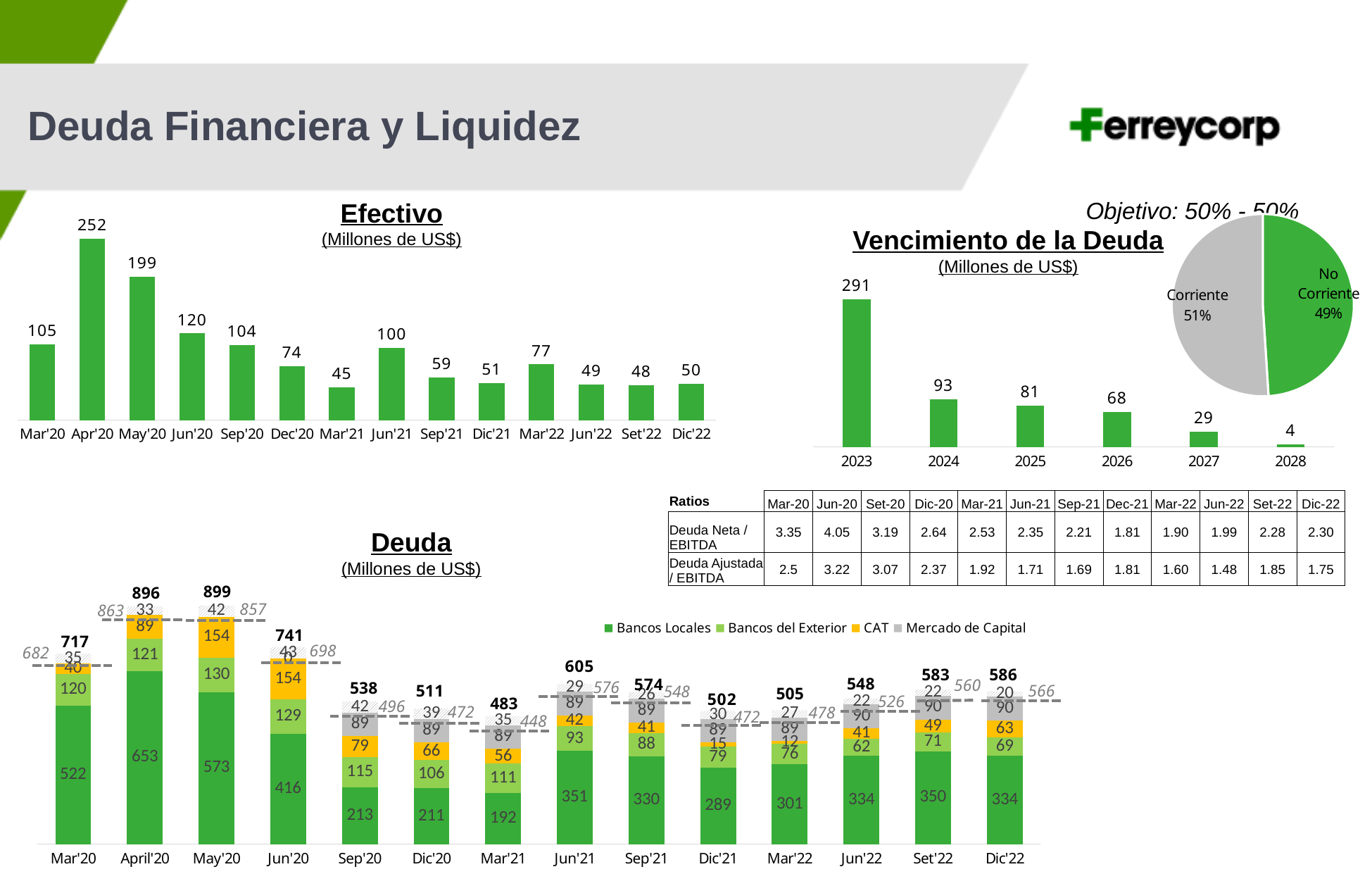
In the Deuda chart, what is the Bancos Locales value for April'20? 653 In the Deuda chart, what is the total for Dic'22? 586 In the Vencimiento de la Deuda chart, how many years are shown? 6 In the Deuda chart, how many series does the legend list? 4 In the Vencimiento de la Deuda chart, what is the value for 2023? 291 In the Efectivo chart, what is the difference between the values for Apr'20 and May'20? 53 In the Efectivo chart, how many periods are plotted? 14 In the pie chart at the top right, what share is Corriente? 51% In the Efectivo chart, which period has the lowest value? Mar'21 In the Vencimiento de la Deuda chart, do the values rise or fall from 2023 to 2028? fall In the Efectivo chart, which period has the highest value? Apr'20 In the Efectivo chart, what is the value for Apr'20? 252